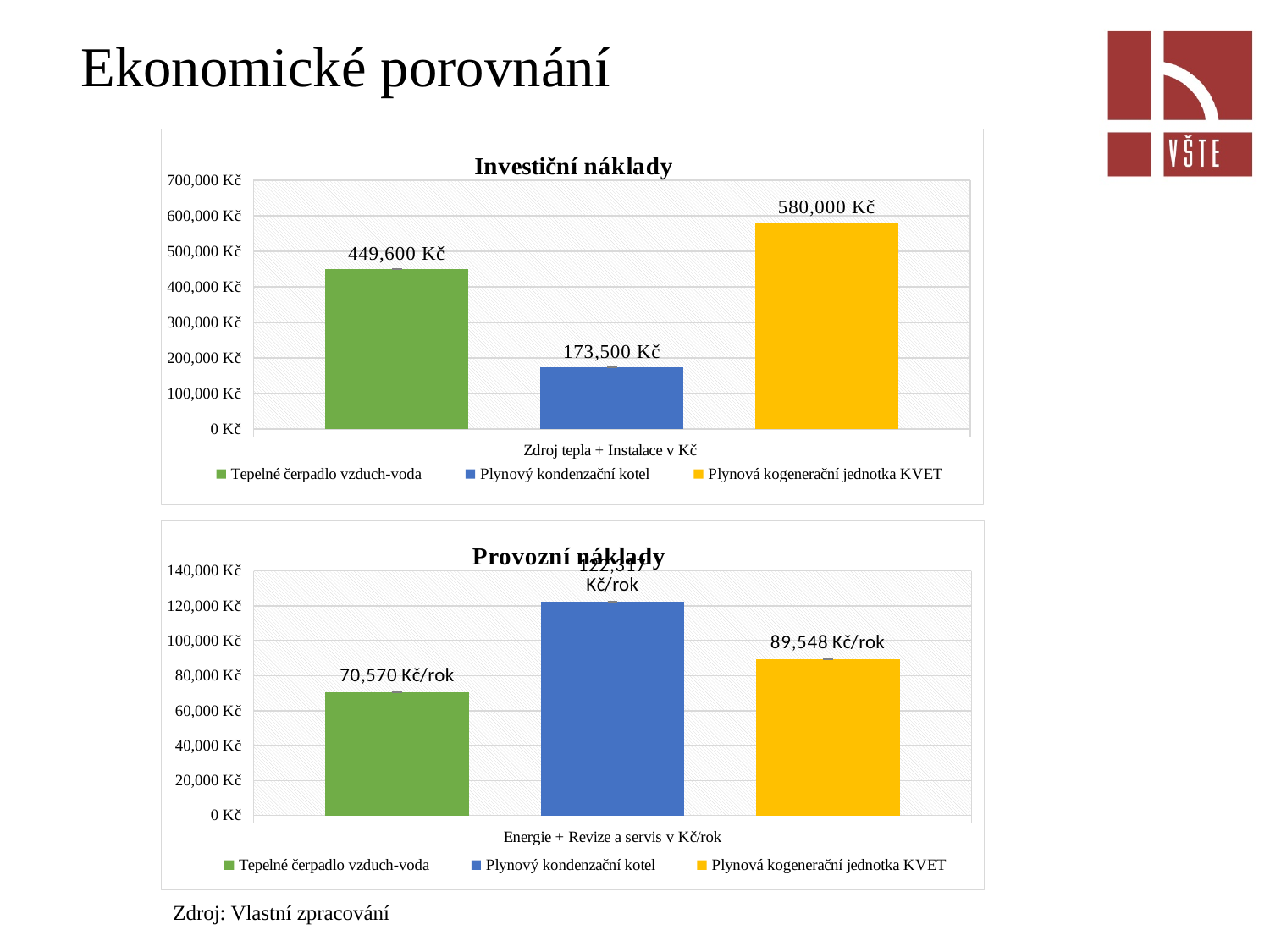
In the 'Investiční náklady' chart, which series has the lowest value? Plynový kondenzační kotel In the 'Provozní náklady' chart, what is the value for Plynová kogenerační jednotka KVET? 89,548 Kč/rok In the 'Investiční náklady' chart, what is the value for Tepelné čerpadlo vzduch-voda? 449,600 Kč In the 'Investiční náklady' chart, what is the value for Plynová kogenerační jednotka KVET? 580,000 Kč In the 'Investiční náklady' chart, which series has the highest value? Plynová kogenerační jednotka KVET In the 'Provozní náklady' chart, what is the value for Tepelné čerpadlo vzduch-voda? 70,570 Kč/rok What kind of chart is the 'Investiční náklady' chart? bar chart In the 'Investiční náklady' chart, what is the value for Plynový kondenzační kotel? 173,500 Kč In the 'Provozní náklady' chart, is the value for Plynový kondenzační kotel greater or less than 100,000 Kč? greater In the 'Provozní náklady' chart, which series has the highest value? Plynový kondenzační kotel How many series does the legend of the 'Provozní náklady' chart list? 3 In the 'Investiční náklady' chart, what is the difference between Plynová kogenerační jednotka KVET and Tepelné čerpadlo vzduch-voda? 130,400 Kč